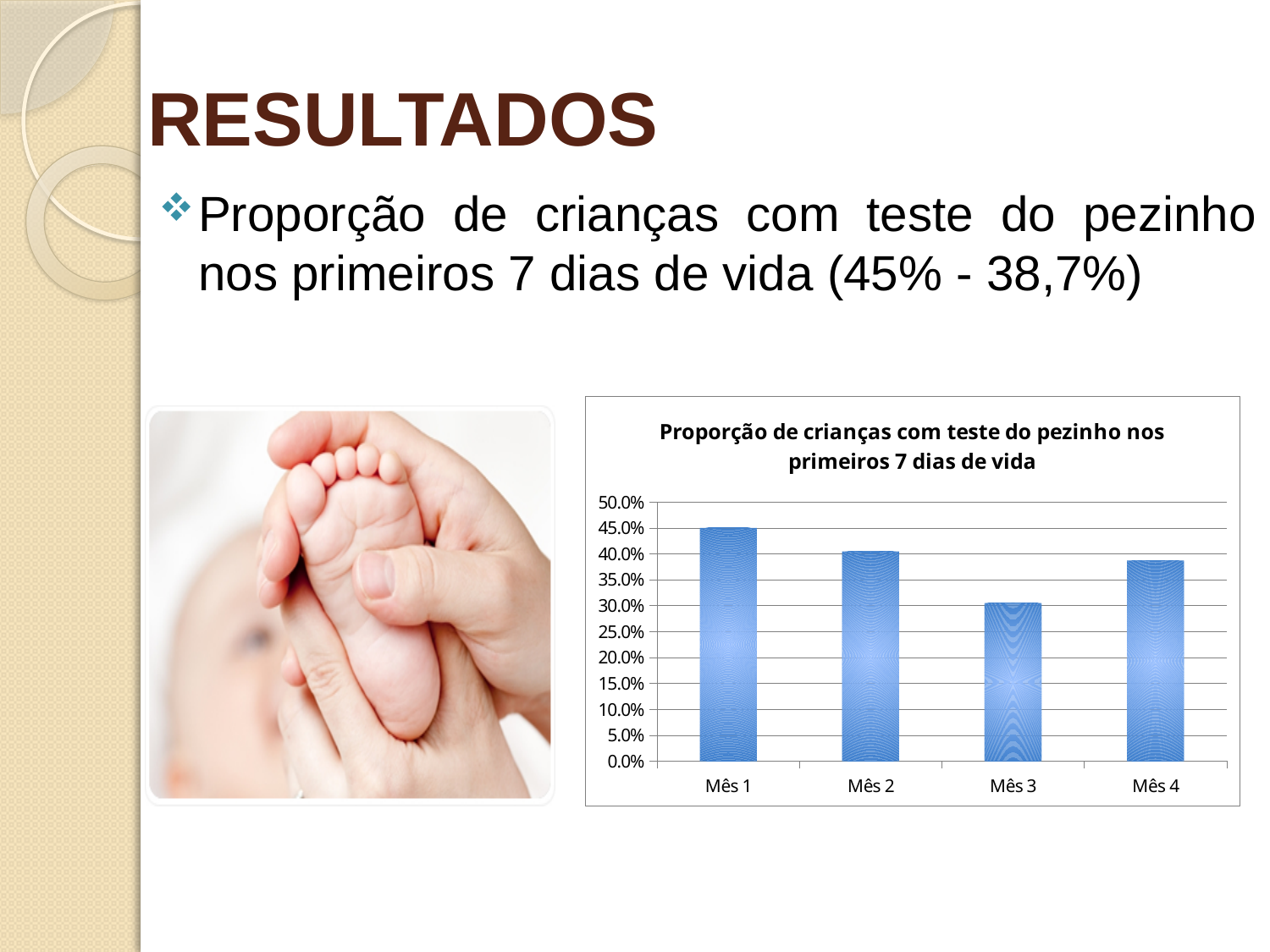
What is the value for Mês 1 in the chart? 45.0% What is the highest value shown on the y axis of the chart? 50.0% Which month has the lowest proportion in the chart? Mês 3 What is the title of the chart? Proporção de crianças com teste do pezinho nos primeiros 7 dias de vida Which month has the highest proportion in the chart? Mês 1 How many categories (months) are shown on the x axis of the chart? 4 Do the values rise or fall from Mês 1 to Mês 3? fall Which is larger, the value for Mês 1 or the value for Mês 3? Mês 1 Is the value for Mês 2 greater or less than 35.0%? greater Is the value for Mês 4 greater or less than 40.0%? less Is the value for Mês 3 greater or less than 35.0%? less What kind of chart is shown on the slide? bar chart